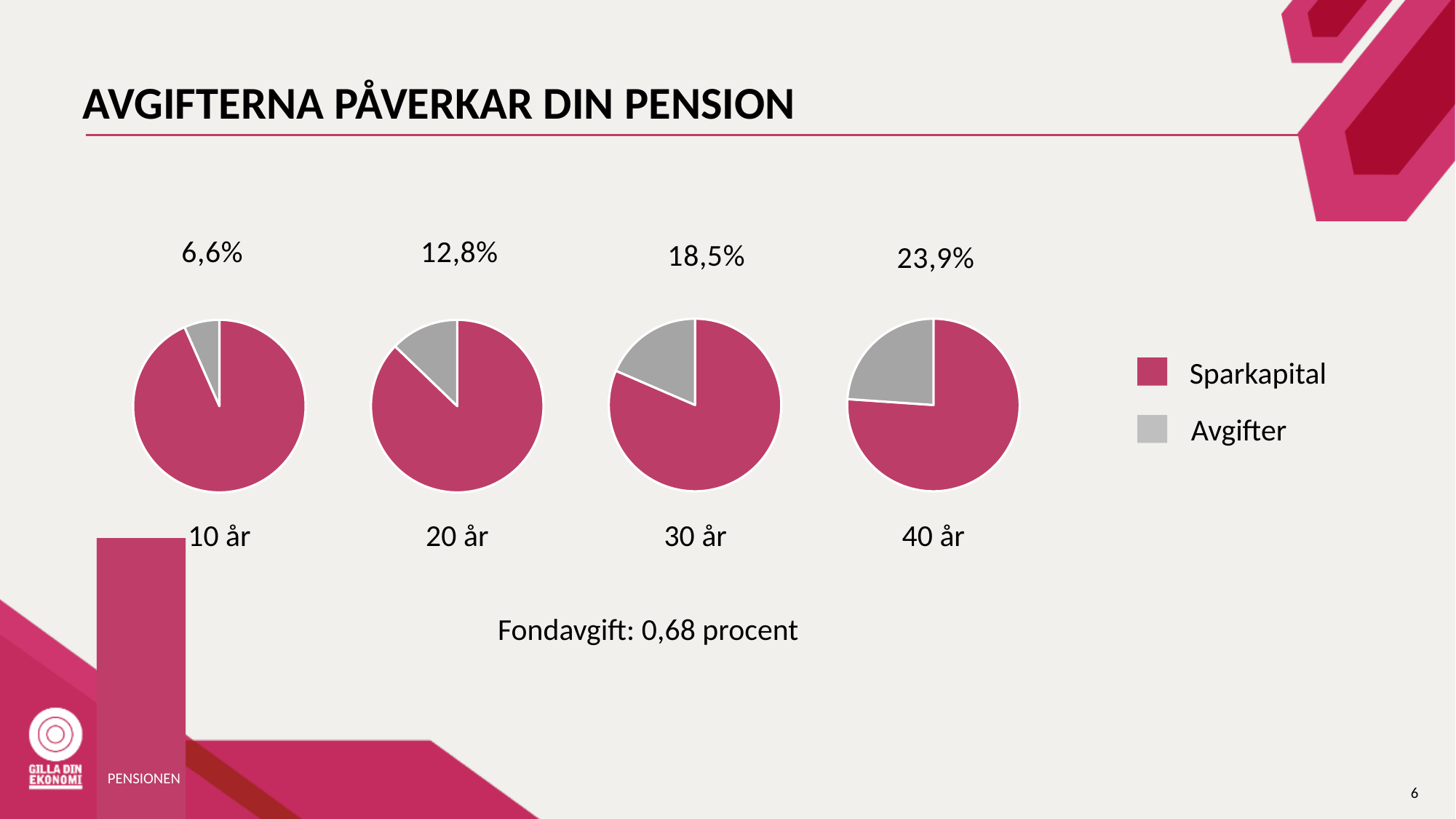
How many entries does the legend list? 2 How many pie charts are shown on the slide? 4 Which pie chart has the smallest Avgifter (grey) slice? 10 år What kind of charts are shown on the slide? Pie charts What is the difference between the percentage shown for 40 år and the percentage shown for 10 år? 17,3% What percentage is shown above the pie chart labelled 10 år? 6,6% Which has a larger grey Avgifter slice, the 20 år pie chart or the 30 år pie chart? 30 år What percentage is shown above the pie chart labelled 40 år? 23,9% What percentage is shown above the pie chart labelled 20 år? 12,8% What percentage is shown above the pie chart labelled 30 år? 18,5% Which pie chart has the largest Avgifter (grey) slice? 40 år Do the percentages shown above the pie charts rise or fall from 10 år to 40 år? Rise